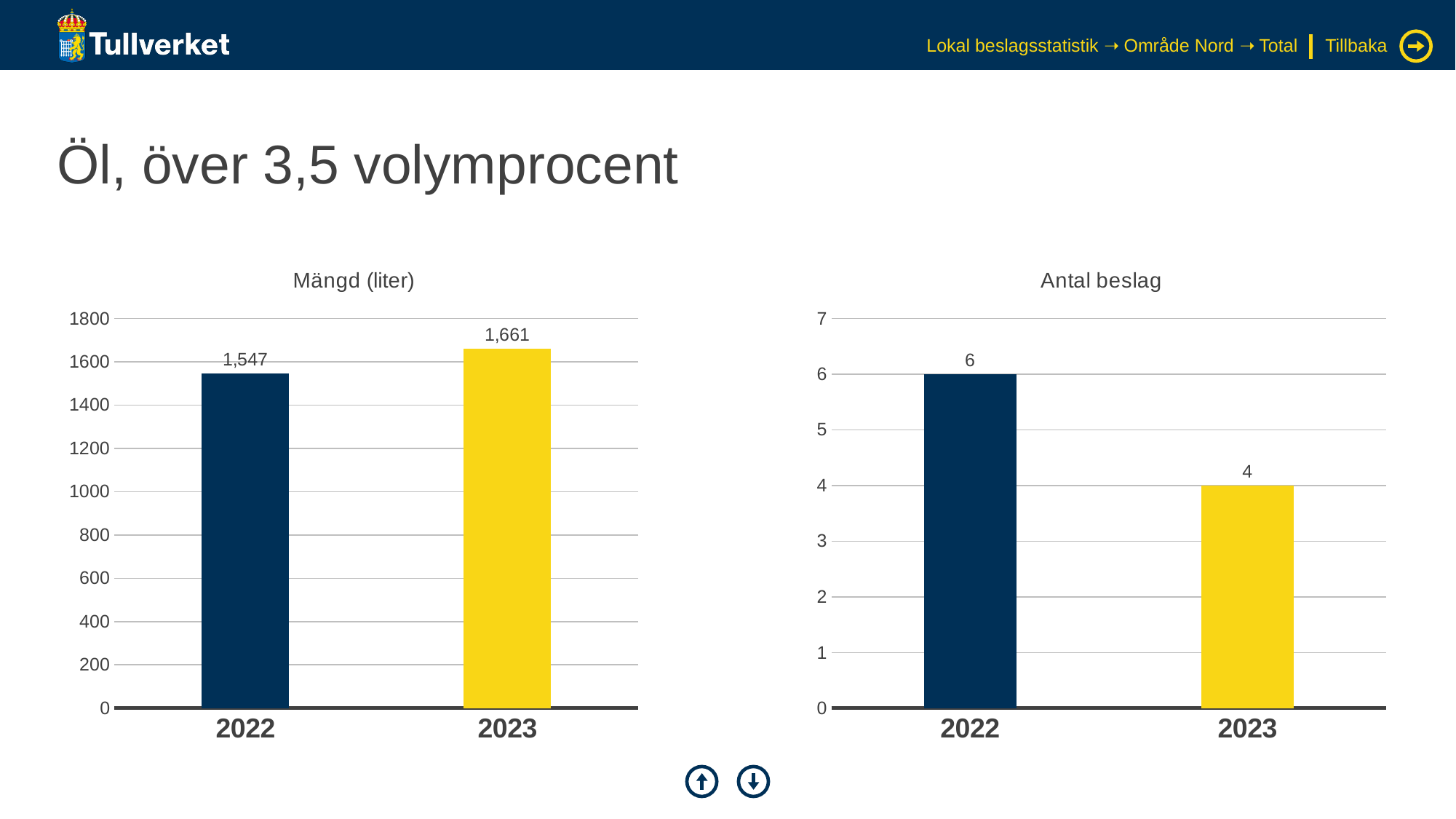
In the 'Mängd (liter)' chart, what is the value for 2023? 1,661 In the 'Mängd (liter)' chart, what is the difference between the 2023 and 2022 values? 114 In the 'Antal beslag' chart, what is the difference between the 2022 and 2023 values? 2 In the 'Mängd (liter)' chart, is the value for 2022 greater or less than 1600? less In the 'Antal beslag' chart, which year has the lowest value? 2023 How many categories are shown in the 'Antal beslag' chart? 2 In the 'Mängd (liter)' chart, what is the value for 2022? 1,547 In the 'Antal beslag' chart, what is the value for 2022? 6 What kind of chart is the 'Mängd (liter)' chart? bar chart In the 'Mängd (liter)' chart, which year has the highest value? 2023 In the 'Antal beslag' chart, what is the value for 2023? 4 In the 'Antal beslag' chart, which is larger, the value for 2022 or 2023? 2022